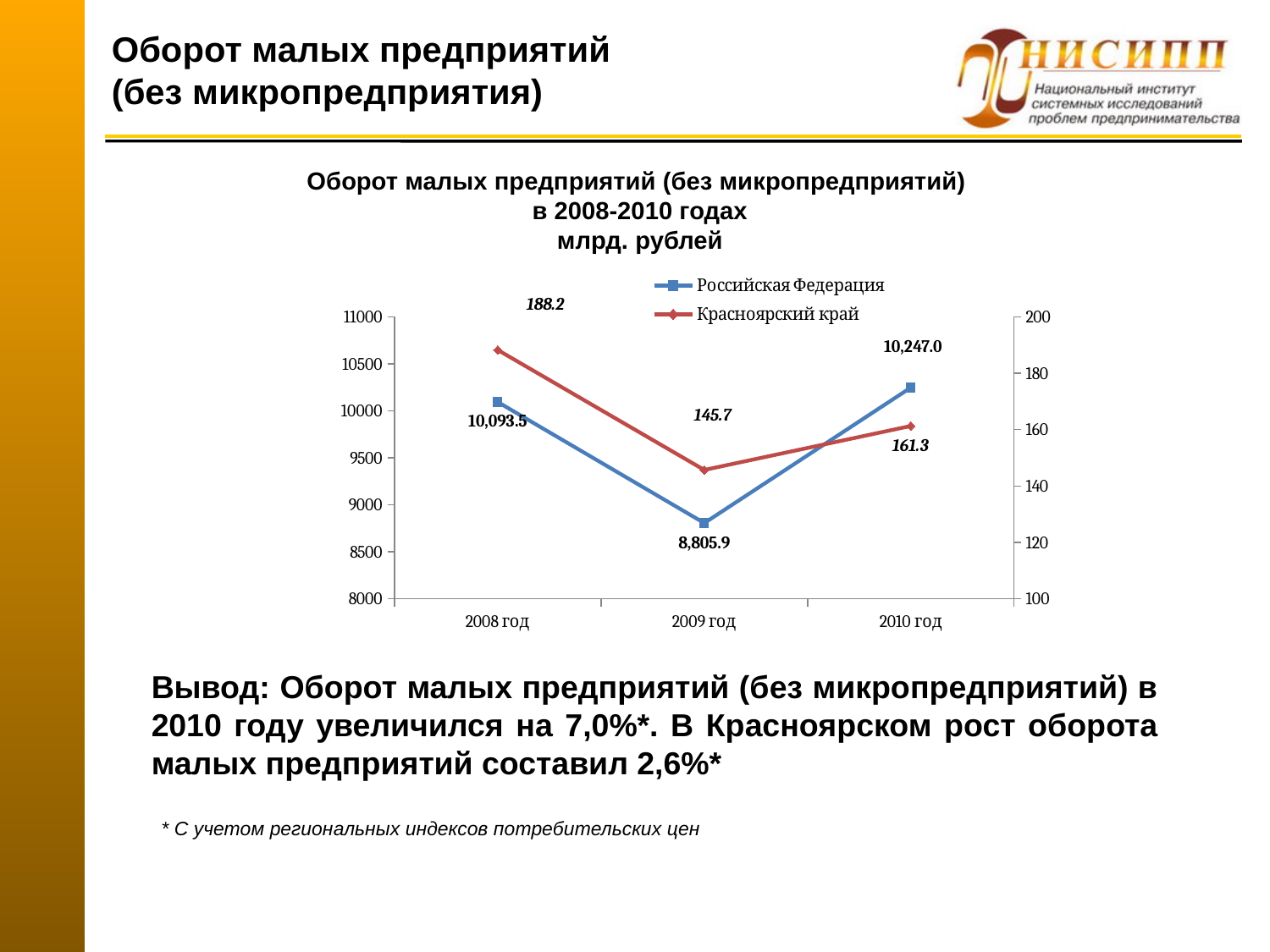
Which is larger for Российская Федерация: the value in 2008 год or in 2010 год? 2010 год In which year is the value for Красноярский край highest? 2008 год What is the value for Российская Федерация in 2010 год? 10,247.0 How many series does the legend list? 2 What is the difference between the Красноярский край values in 2008 год and 2009 год? 42.5 What is the difference between the Российская Федерация values in 2010 год and 2009 год? 1,441.1 In which year is the value for Российская Федерация lowest? 2009 год How does the value for Красноярский край change from 2008 год to 2009 год? falls What is the value for Красноярский край in 2010 год? 161.3 What kind of chart is shown on the slide? line chart What is the value for Российская Федерация in 2009 год? 8,805.9 What is the value for Красноярский край in 2008 год? 188.2